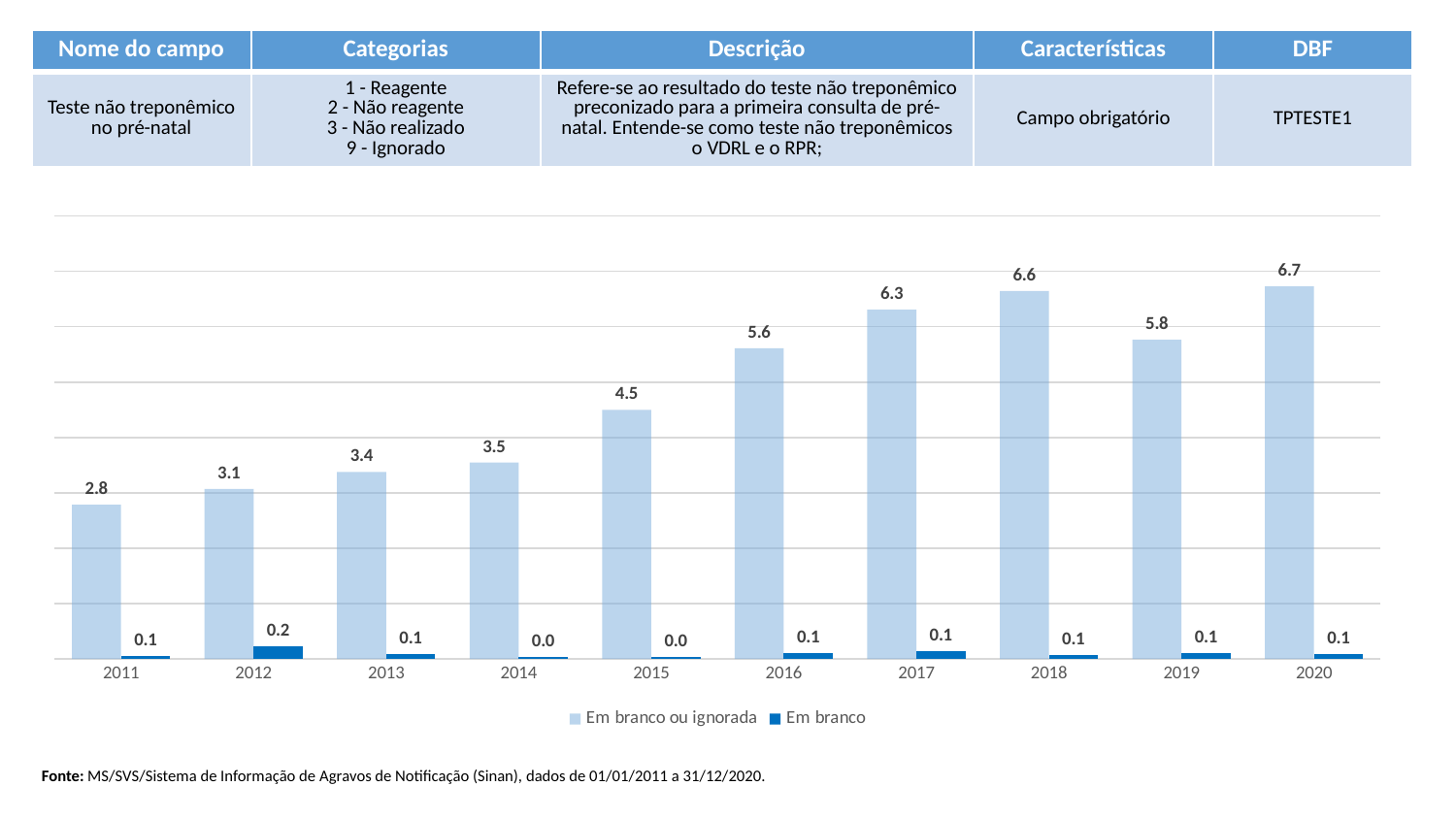
How many series does the legend list? 2 What is the value for "Em branco" in 2012? 0.2 Which year has the highest value for "Em branco ou ignorada"? 2020 Which year has the lowest value for "Em branco ou ignorada"? 2011 What is the difference between the "Em branco ou ignorada" values for 2018 and 2019? 0.8 What kind of chart is shown on the slide? Bar chart Which is larger for "Em branco ou ignorada": 2017 or 2019? 2017 Does the "Em branco ou ignorada" series generally rise or fall from 2011 to 2018? Rise What is the value for "Em branco ou ignorada" in 2011? 2.8 Which series is shown in dark blue in the legend? Em branco What is the value for "Em branco ou ignorada" in 2016? 5.6 How many years are shown on the x axis? 10